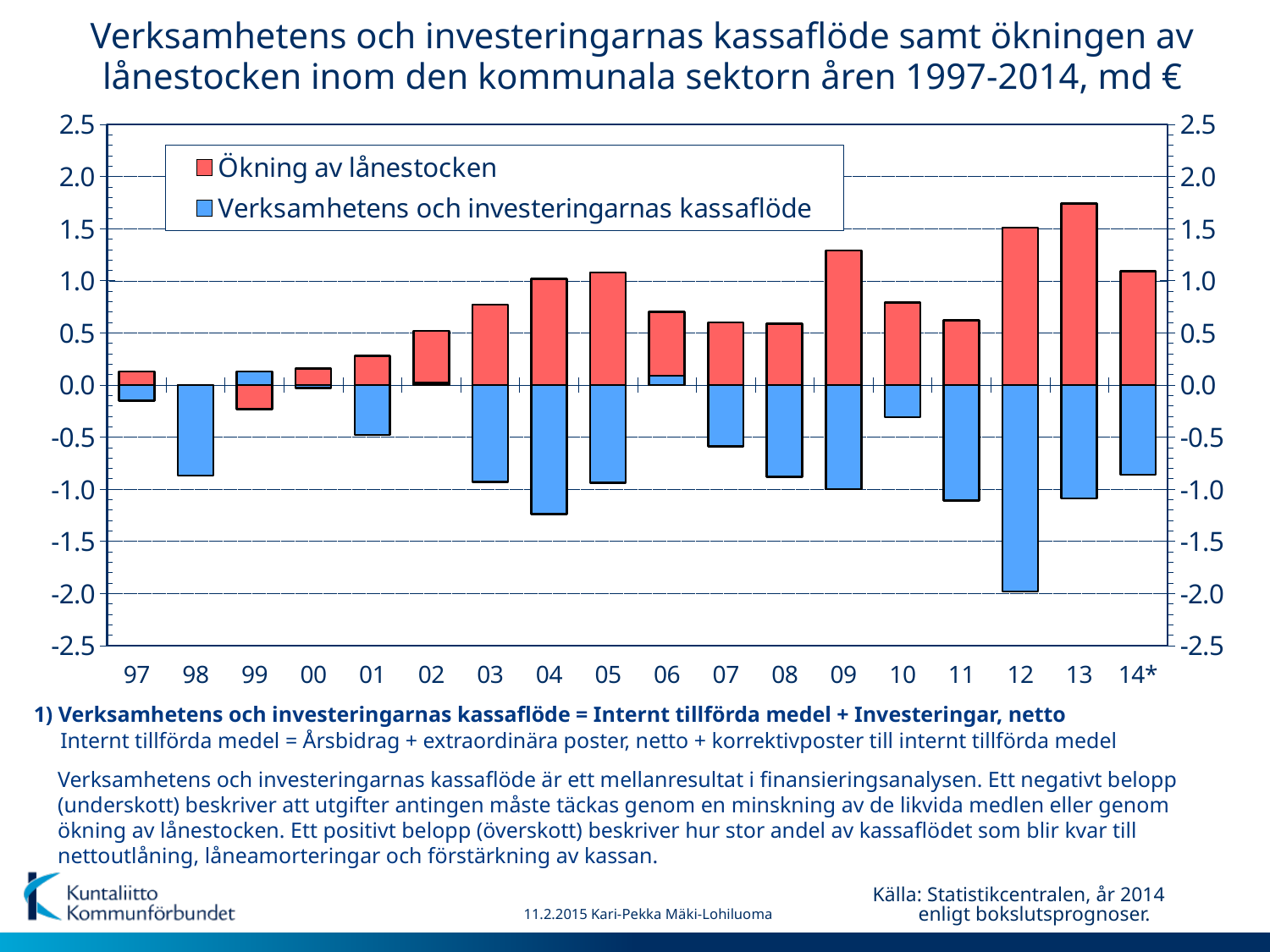
Which year has the larger value for Verksamhetens och investeringarnas kassaflöde, 11 or 12? 11 In which year is the value for Verksamhetens och investeringarnas kassaflöde lowest? 12 Which year has the larger value for Ökning av lånestocken, 12 or 13? 13 In which year is the value for Ökning av lånestocken highest? 13 Is the value for Verksamhetens och investeringarnas kassaflöde in 10 greater or less than -0.5? greater Is the value for Verksamhetens och investeringarnas kassaflöde in 12 greater or less than -1.5? less Is the value for Ökning av lånestocken in 09 greater or less than 1.0? greater What colour are the bars for Ökning av lånestocken? red How many series does the legend list? 2 How many years (categories) are shown on the x axis? 18 What kind of chart is shown on the slide? bar chart